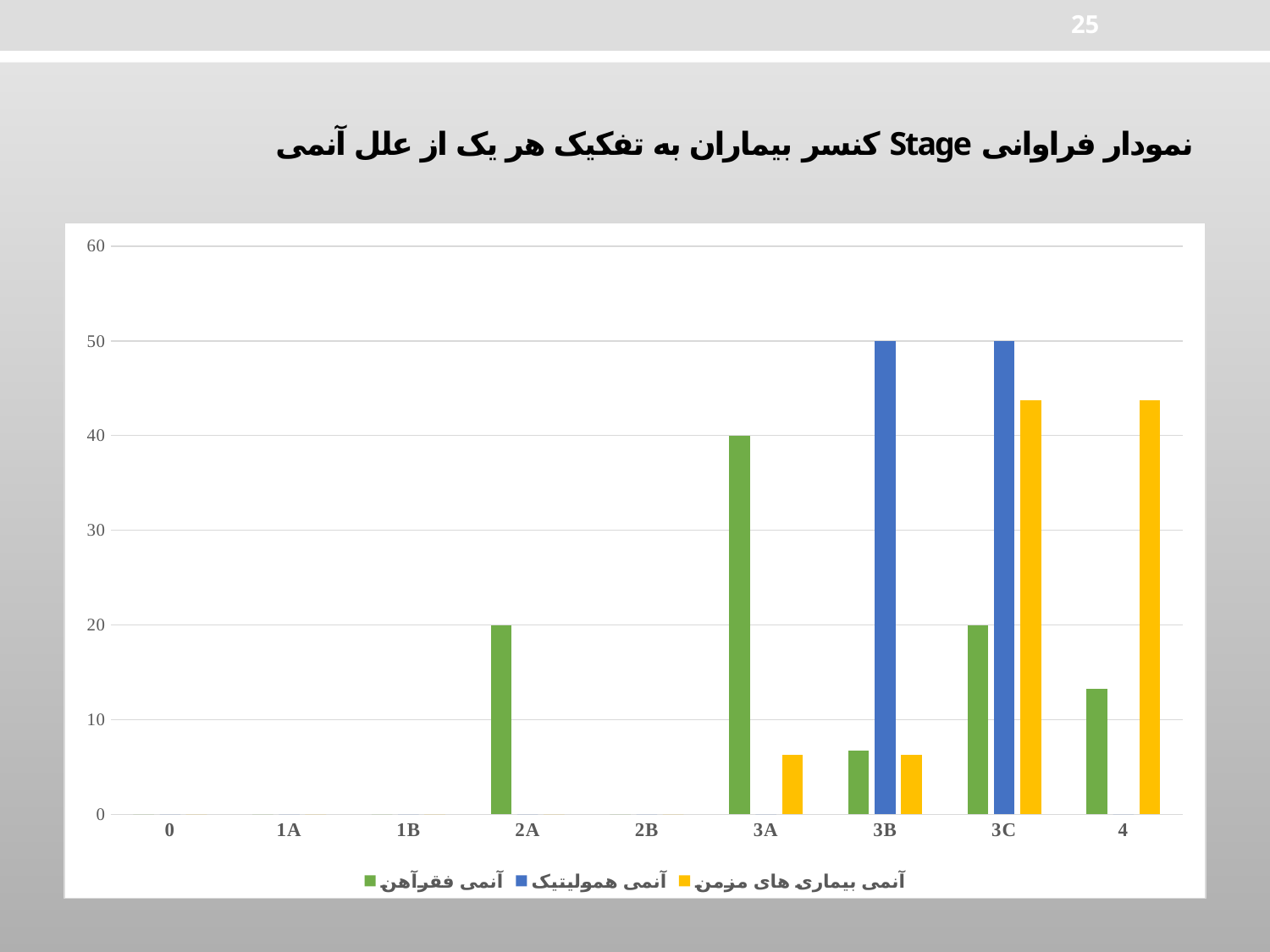
At stage 3C, which series has the larger value: the blue series (آنمی همولیتیک) or the green series (آنمی فقرآهن)? blue series (آنمی همولیتیک) What is the value of the blue series (آنمی همولیتیک) at stage 3C? 50 What is the value of the blue series (آنمی همولیتیک) at stage 3B? 50 How many series does the legend list? 3 At which stage does the green series (آنمی فقرآهن) reach its highest value? 3A What is the value of the green series (آنمی فقرآهن) at stage 2A? 20 Is the value of the green series (آنمی فقرآهن) at stage 4 greater or less than 20? less How many stage categories are shown on the x axis? 9 Is the value of the yellow series (آنمی بیماری های مزمن) at stage 4 greater or less than 40? greater What is the difference between the green series (آنمی فقرآهن) values at stage 3A and stage 2A? 20 What is the value of the green series (آنمی فقرآهن) at stage 3A? 40 What kind of chart is shown on the slide? bar chart